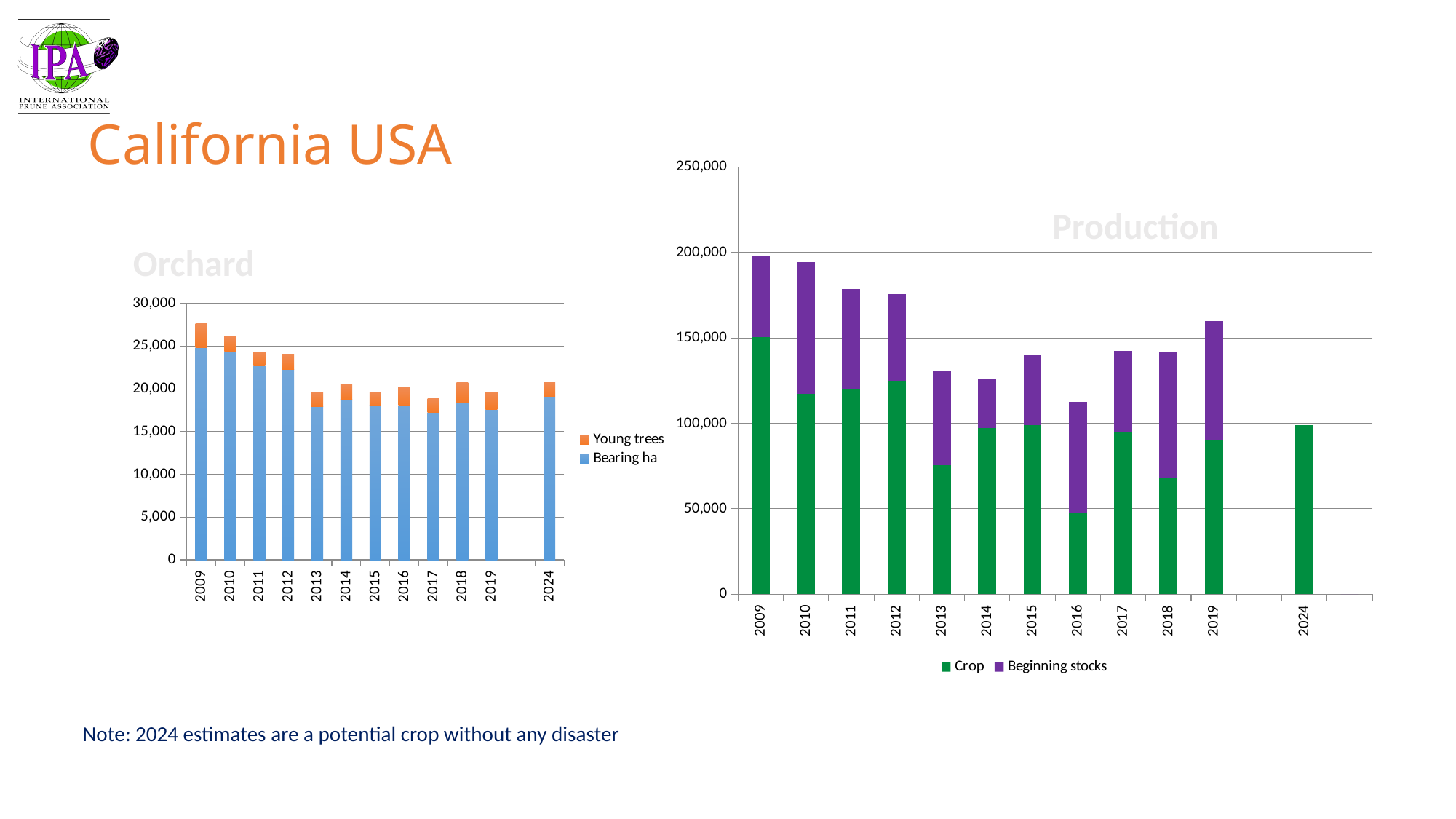
In the Orchard chart, is the Bearing ha value for 2013 greater or less than 20,000? less In the Production chart, is the Crop value for 2009 larger or smaller than the Crop value for 2013? larger What type of chart is the Orchard chart? stacked bar chart In the Orchard chart, which year has the highest total bar? 2009 What are the two legend entries of the Orchard chart? Young trees and Bearing ha In the Production chart, is the Crop value for 2012 greater or less than 100,000? greater In the Production chart, which year has the highest total bar? 2009 In the Production chart, which year has the lowest Crop value? 2016 How many years are shown on the x axis of the Orchard chart? 12 In the Orchard chart, is the Bearing ha value for 2009 greater or less than 20,000? greater How many series does the legend of the Production chart list? 2